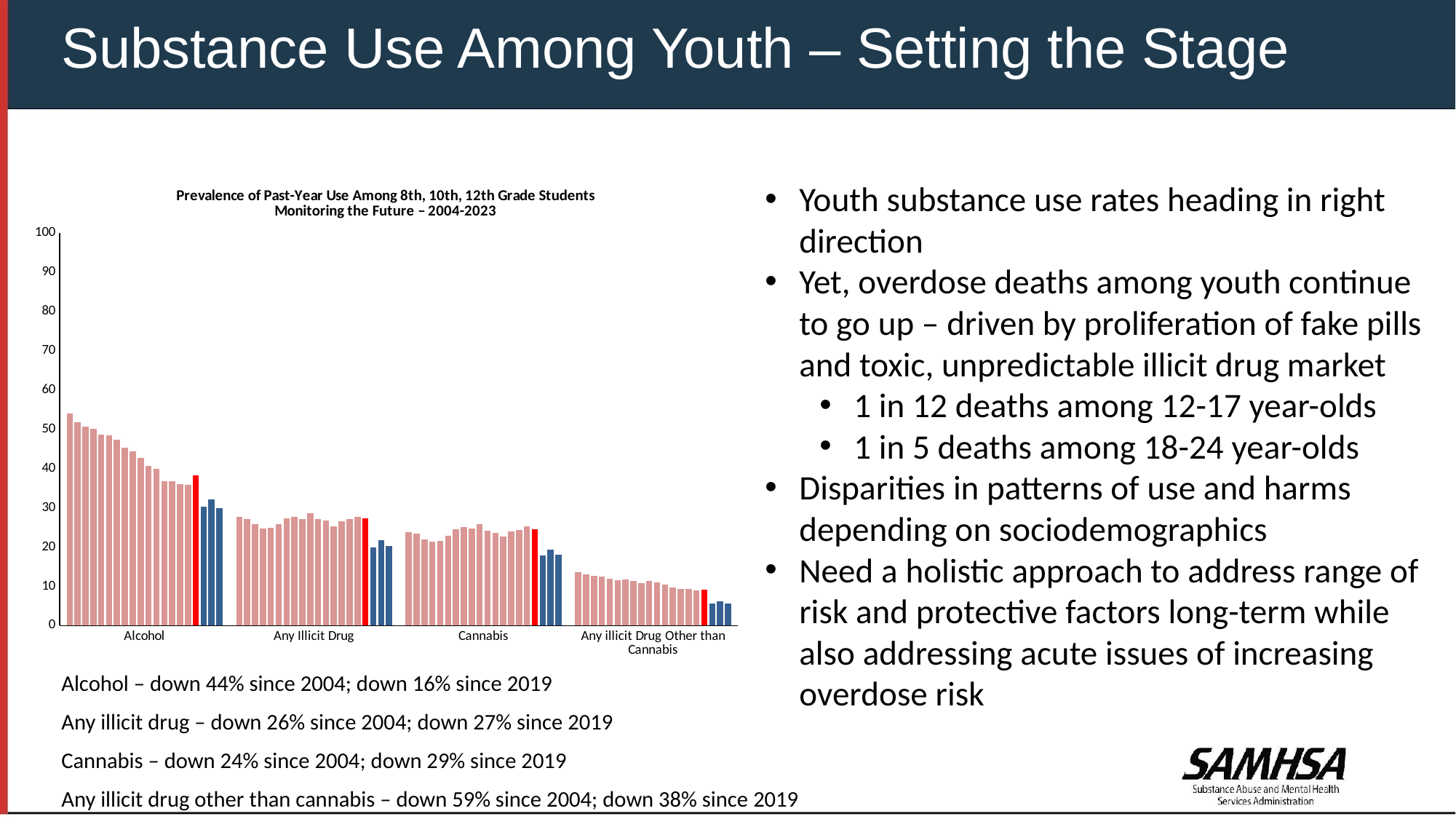
Are the bars for Any illicit Drug Other than Cannabis greater or less than 20? less What is the title of the chart? Prevalence of Past-Year Use Among 8th, 10th, 12th Grade Students Monitoring the Future – 2004-2023 Are the bars for Cannabis greater or less than 30? less What kind of chart is shown on the slide? Bar chart How many substance categories are shown along the x axis of the chart? 4 Which substance category has the lowest bars in the chart? Any illicit Drug Other than Cannabis Which substance category has the highest bars in the chart? Alcohol Which is larger: the leftmost bar for Alcohol or the leftmost bar for Cannabis? Alcohol Is the value of the first (leftmost) Alcohol bar greater or less than 40? greater What is the maximum value shown on the chart's y axis? 100 Do the Alcohol bars generally rise or fall from left to right? Fall